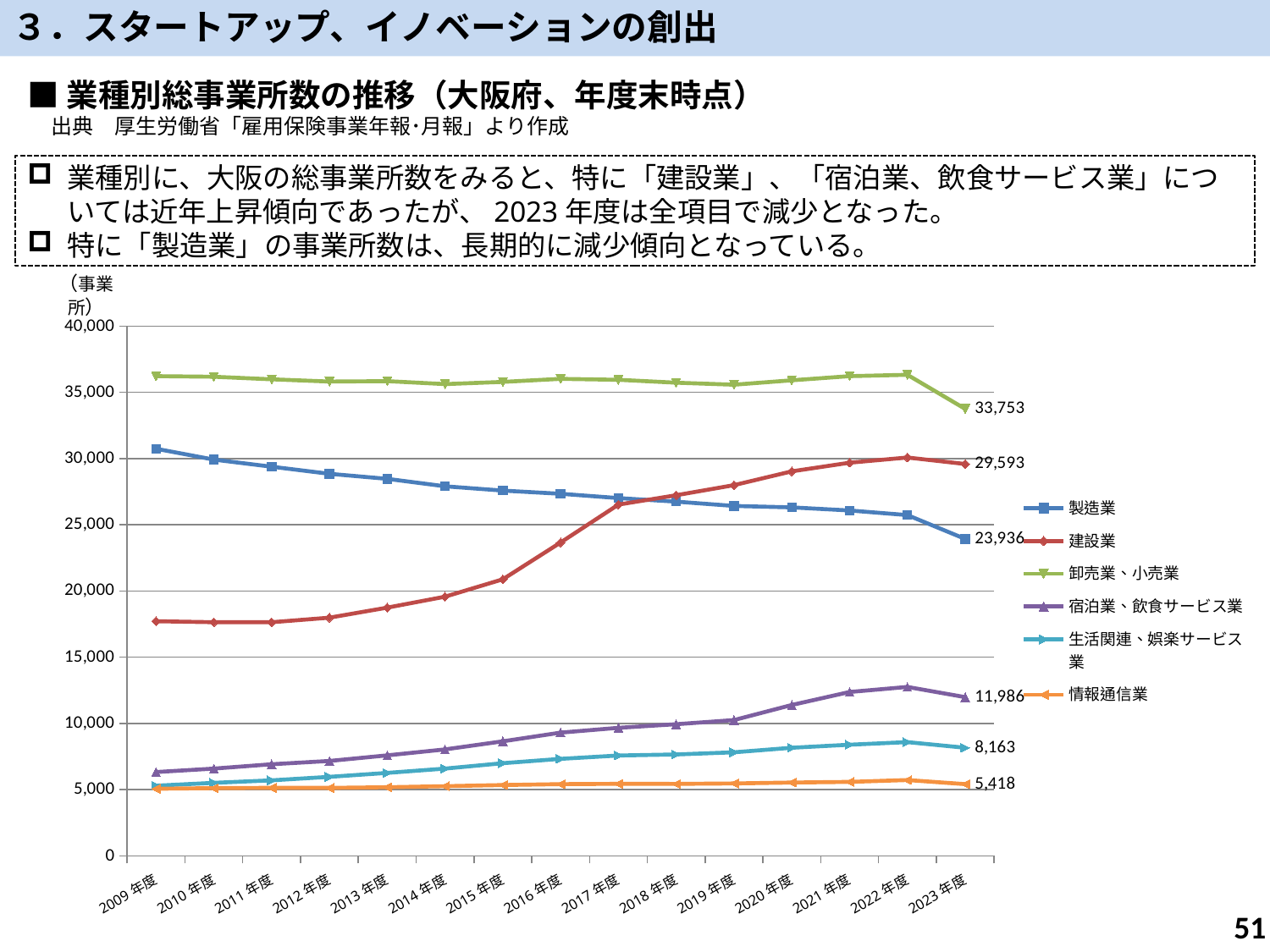
What is the value for 情報通信業 in 2023年度? 5,418 Which series has the highest value in 2023年度? 卸売業、小売業 What is the difference between 建設業 and 製造業 in 2023年度? 5,657 What is the value for 卸売業、小売業 in 2023年度? 33,753 How many series does the legend list? 6 Does the value for 製造業 rise or fall from 2009年度 to 2023年度? fall What is the value for 建設業 in 2023年度? 29,593 What kind of chart is shown on the slide? line chart What is the value for 製造業 in 2023年度? 23,936 How many fiscal years are plotted along the x axis? 15 Is the value for 建設業 in 2009年度 greater or less than 20,000? less Which series has the lowest value in 2023年度? 情報通信業